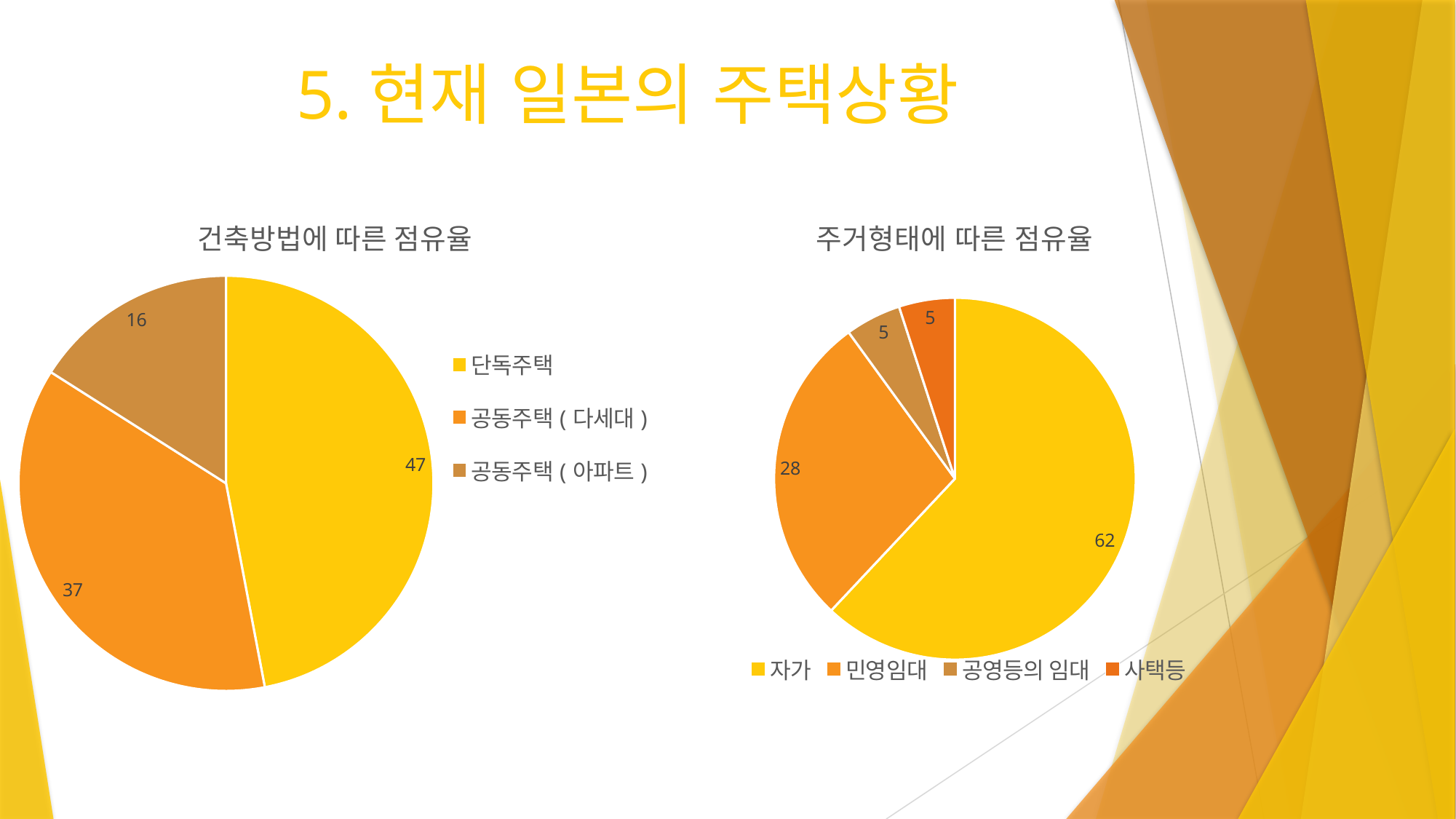
In the chart titled 주거형태에 따른 점유율, what is the value for 민영임대? 28 In the chart titled 주거형태에 따른 점유율, which category has the largest slice? 자가 What kind of chart is the chart titled 건축방법에 따른 점유율? Pie chart In the chart titled 건축방법에 따른 점유율, what is the value for 공동주택 ( 아파트 )? 16 In the chart titled 건축방법에 따른 점유율, what is the value for 단독주택? 47 In the chart titled 건축방법에 따른 점유율, which category has the smallest slice? 공동주택 ( 아파트 ) In the chart titled 건축방법에 따른 점유율, how many categories are shown? 3 In the chart titled 주거형태에 따른 점유율, what is the difference between the values for 자가 and 민영임대? 34 In the chart titled 주거형태에 따른 점유율, how many entries does the legend list? 4 In the chart titled 건축방법에 따른 점유율, what is the difference between the values for 단독주택 and 공동주택 ( 다세대 )? 10 In the chart titled 주거형태에 따른 점유율, which is larger, 민영임대 or 사택등? 민영임대 In the chart titled 주거형태에 따른 점유율, what is the value for 자가? 62